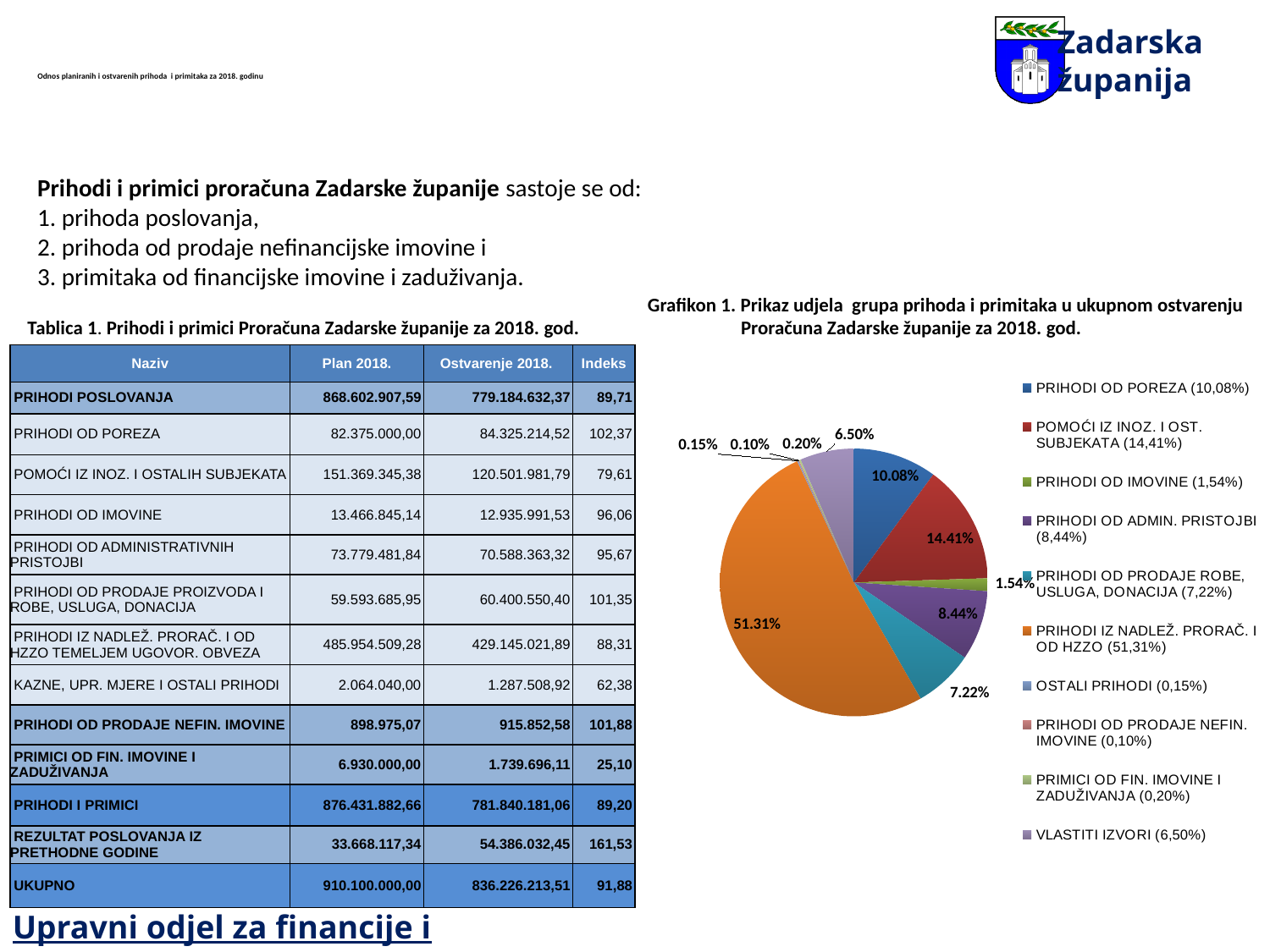
What is the difference in percentage points between the shares of POMOĆI IZ INOZ. I OST. SUBJEKATA and PRIHODI OD POREZA? 4.33 Which has a larger share: PRIHODI OD ADMIN. PRISTOJBI or PRIHODI OD PRODAJE ROBE, USLUGA, DONACIJA? PRIHODI OD ADMIN. PRISTOJBI What share of the pie does VLASTITI IZVORI have? 6.50% Which category has the smallest slice of the pie? PRIHODI OD PRODAJE NEFIN. IMOVINE What is the title of the pie chart? Grafikon 1. Prikaz udjela grupa prihoda i primitaka u ukupnom ostvarenju Proračuna Zadarske županije za 2018. god. How many slices does the pie chart have? 10 What share of the pie does POMOĆI IZ INOZ. I OST. SUBJEKATA have? 14.41% What kind of chart is Grafikon 1? pie chart What share of the pie does PRIHODI OD POREZA have? 10.08% Which category has the largest slice of the pie? PRIHODI IZ NADLEŽ. PRORAČ. I OD HZZO